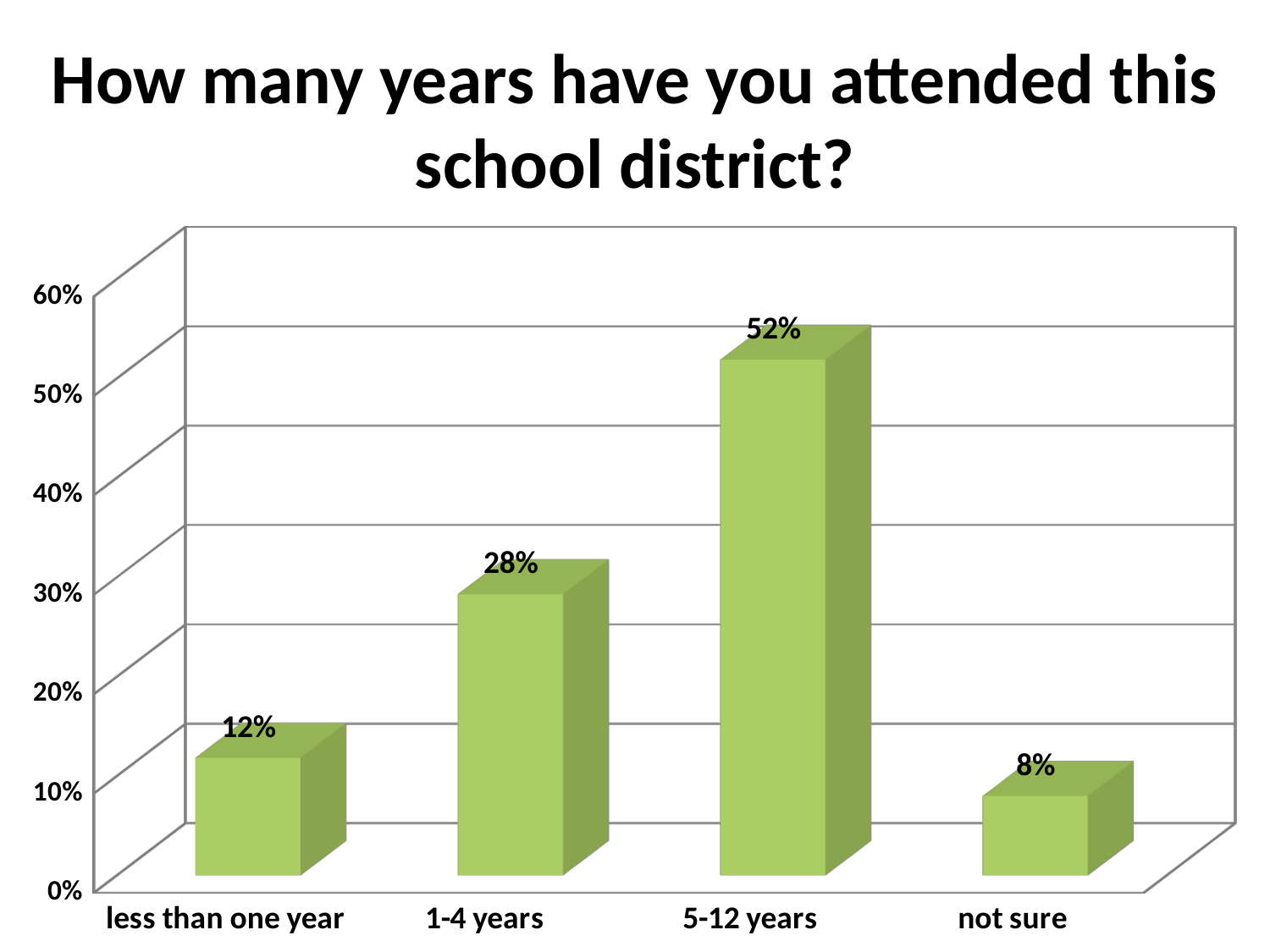
What is the value for the 'not sure' category? 8% How many categories are shown on the x axis? 4 What kind of chart is shown on the slide? bar chart What is the difference between the values for 'less than one year' and 'not sure'? 4% Which is larger, the value for '1-4 years' or the value for 'less than one year'? 1-4 years What is the difference between the values for '5-12 years' and '1-4 years'? 24% Which category has the lowest value? not sure Is the value for '5-12 years' greater or less than 50%? greater What percentage of respondents answered 'less than one year'? 12% What percentage of respondents have attended the school district for 5-12 years? 52% What is the value shown for the '1-4 years' category? 28% Which category has the highest value? 5-12 years